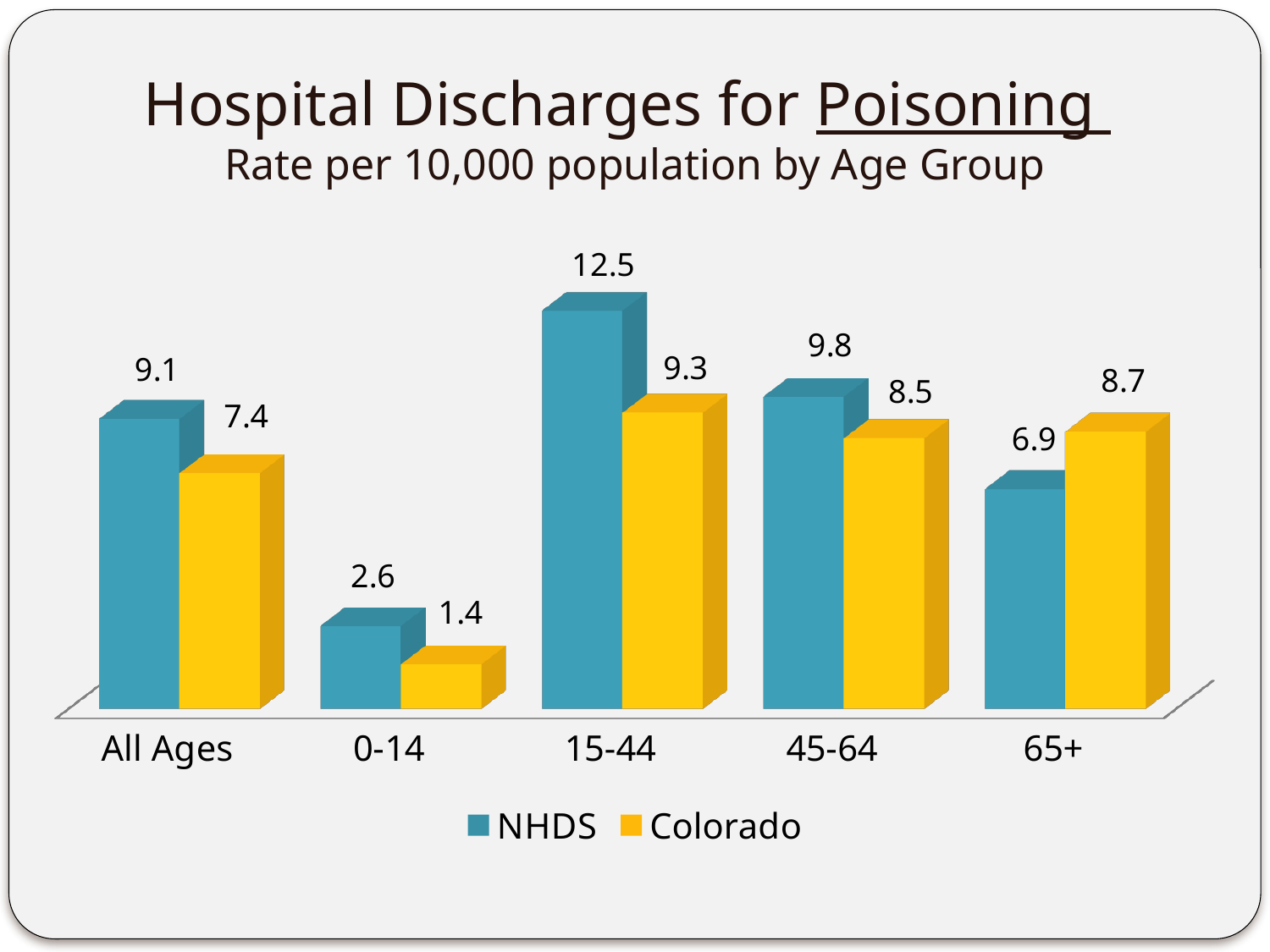
Which age group has the highest NHDS value? 15-44 What is the Colorado value for All Ages? 7.4 What is the NHDS value for the 15-44 age group? 12.5 What is the difference between the NHDS and Colorado values for the 15-44 age group? 3.2 What is the difference between the NHDS values for 45-64 and 65+? 2.9 How many series does the legend list? 2 Which age group has the lowest Colorado value? 0-14 What is the Colorado value for the 65+ age group? 8.7 For the 0-14 age group, which is larger, NHDS or Colorado? NHDS For the 65+ age group, which is larger, NHDS or Colorado? Colorado How many age group categories are shown on the x axis? 5 What kind of chart is shown on the slide? Bar chart